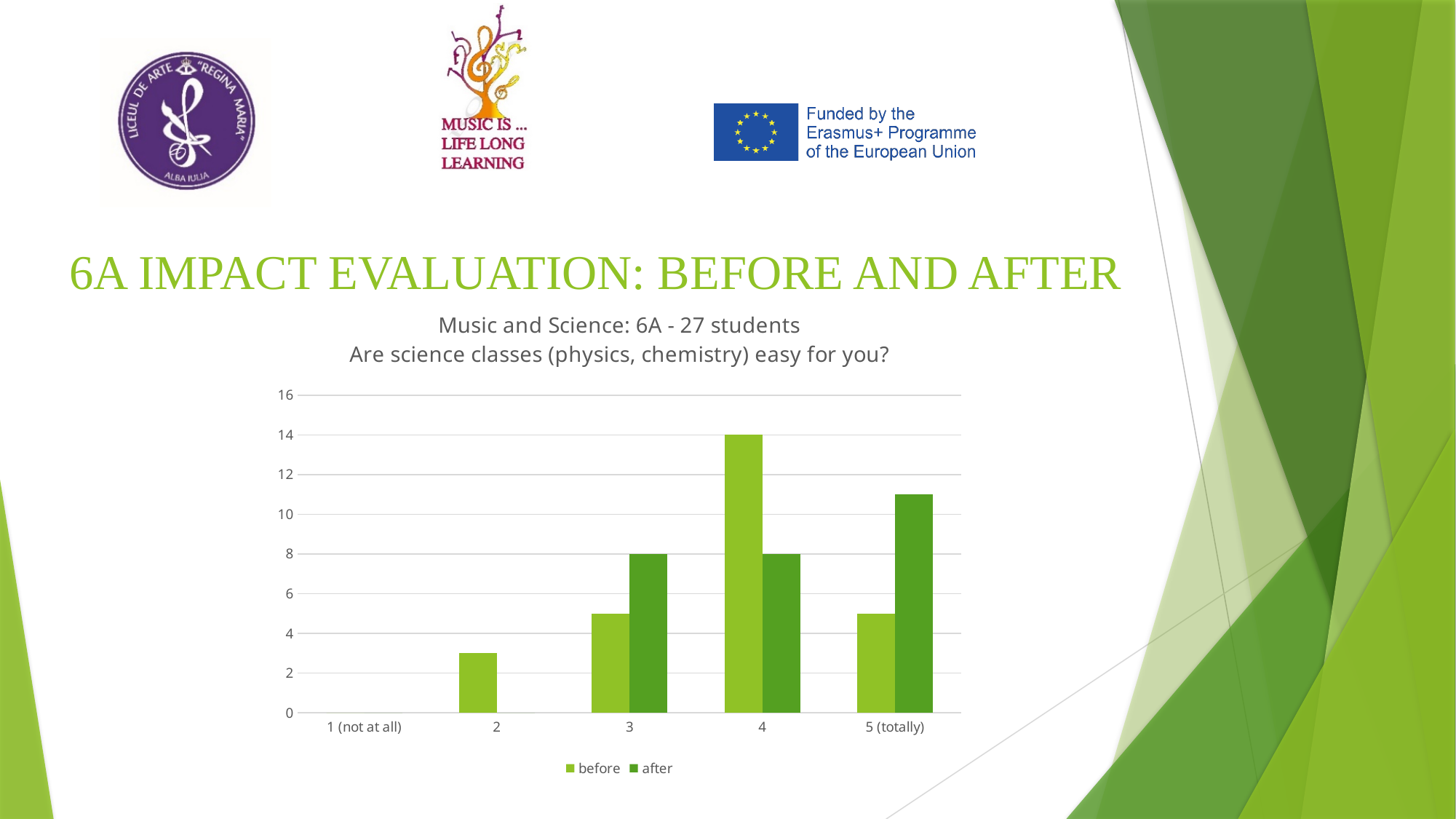
How many categories are shown on the x axis? 5 Is the 'after' value for '5 (totally)' greater or less than 10? greater What kind of chart is shown on the slide? bar chart How many series does the legend list? 2 What is the 'after' value for category 3? 8 Which category has the highest 'before' value? 4 What is the difference between the 'before' and 'after' values for category 4? 6 What is the 'before' value for category 4? 14 What are the two legend entries of the chart? before, after Which category has the highest 'after' value? 5 (totally) Is the 'before' value for category 2 greater or less than 4? less For '5 (totally)', which is larger, the 'before' or the 'after' value? after